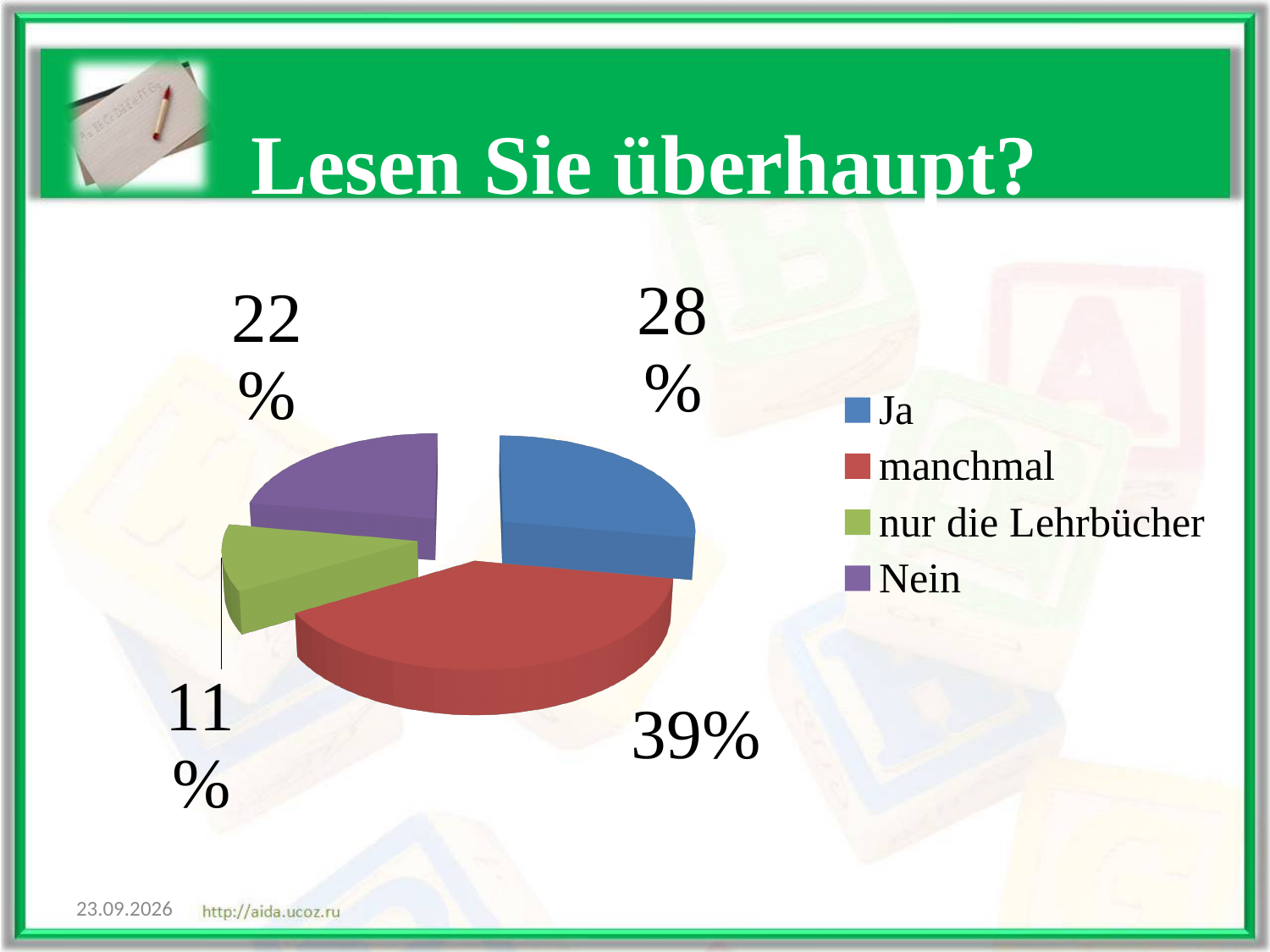
What is the difference in percentage points between the "manchmal" slice and the "Ja" slice? 11 What percentage of the pie is labelled for "Ja"? 28% What is the title of the slide containing the pie chart? Lesen Sie überhaupt? Which slice is larger, "Nein" or "nur die Lehrbücher"? Nein What colour is the "Nein" slice in the pie chart? purple Which category has the smallest slice of the pie? nur die Lehrbücher What kind of chart is shown on the slide? pie chart What percentage of the pie is labelled for "Nein"? 22% What percentage of the pie is labelled for "nur die Lehrbücher"? 11% How many slices does the pie chart have? 4 Which category has the largest slice of the pie? manchmal What percentage of the pie is labelled for "manchmal"? 39%